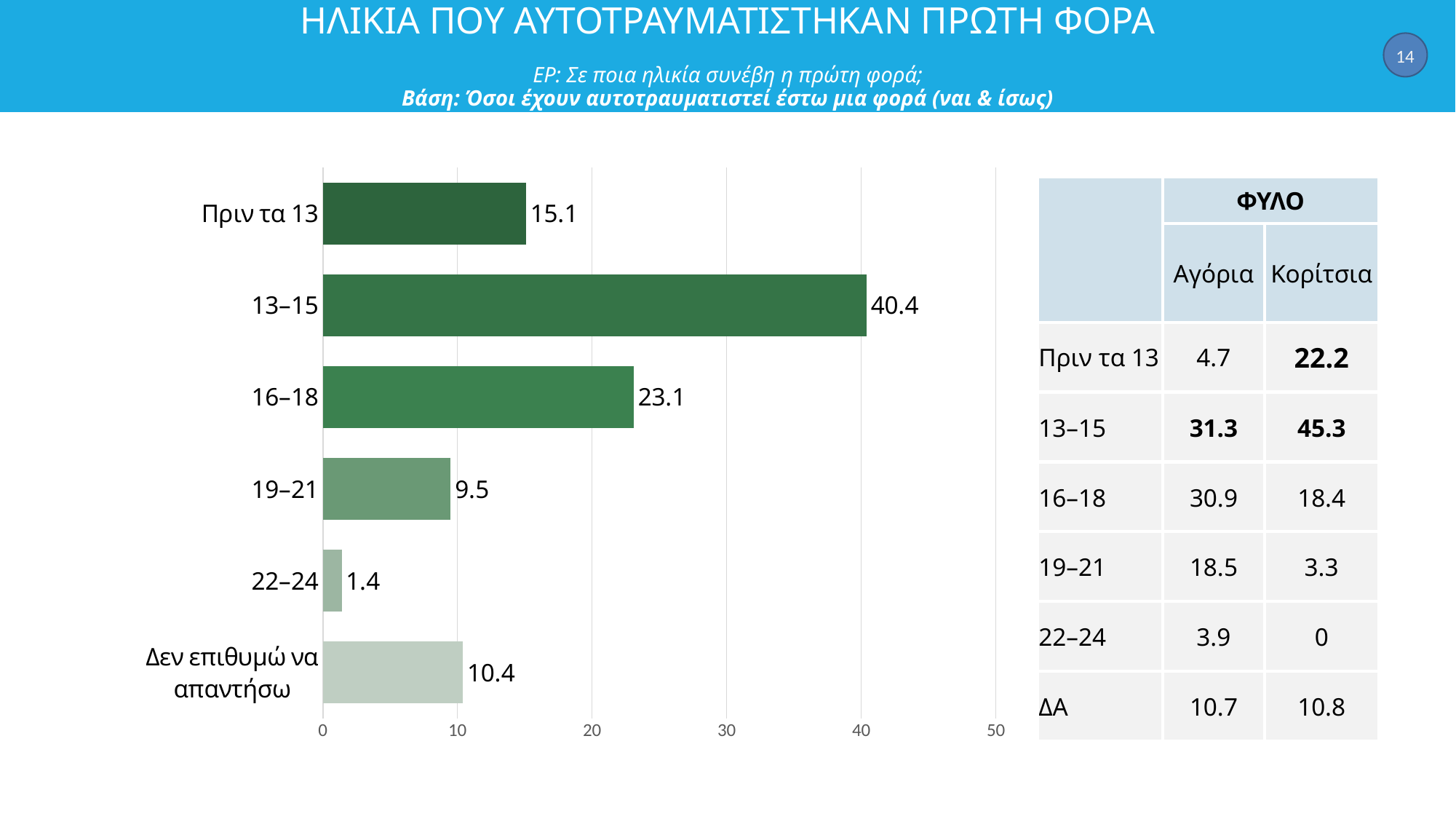
What is the difference between the values for 13–15 and 16–18? 17.3 Is the value for 16–18 greater or less than 20? greater How many categories are shown in the bar chart? 6 What is the value for the 13–15 category? 40.4 Which category has the highest value? 13–15 What is the value for the 'Δεν επιθυμώ να απαντήσω' category? 10.4 Which is larger, the value for 19–21 or the value for 'Δεν επιθυμώ να απαντήσω'? Δεν επιθυμώ να απαντήσω What kind of chart is shown on the slide? bar chart What is the highest tick value shown on the horizontal axis of the chart? 50 What is the difference between the values for 'Πριν τα 13' and 22–24? 13.7 What is the value for the 'Πριν τα 13' category? 15.1 Which category has the lowest value? 22–24